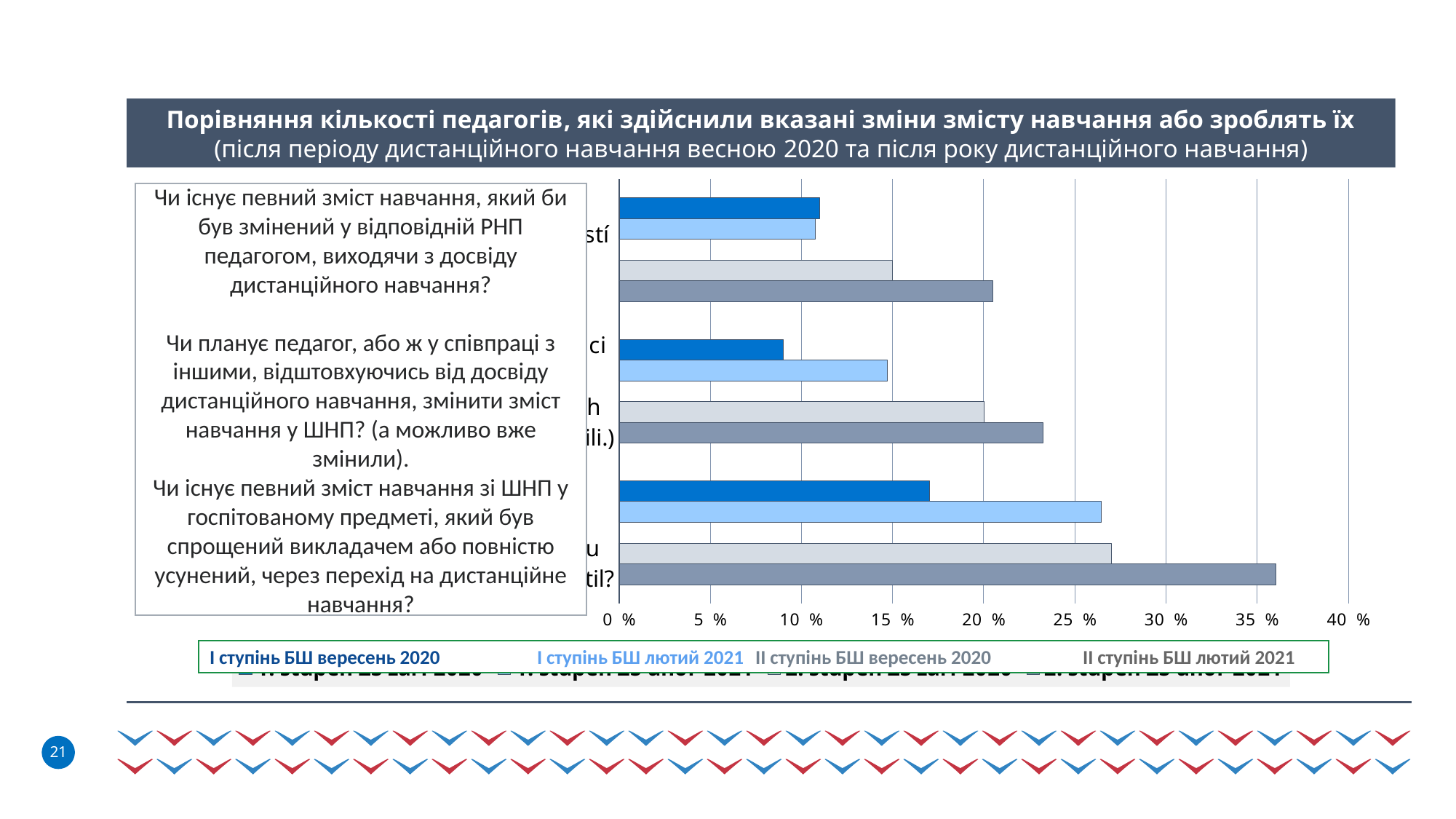
Is the value for ІІ ступінь БШ лютий 2021 in the top category greater or less than 15%? greater How many series does the legend list? 4 How many question categories are plotted on the chart? 3 Which series has the longest bar in the bottom category (content simplified or removed due to distance learning)? ІІ ступінь БШ лютий 2021 What is the maximum value shown on the horizontal axis? 40 % In the middle category, which is larger: І ступінь БШ вересень 2020 or І ступінь БШ лютий 2021? І ступінь БШ лютий 2021 Is the value for І ступінь БШ вересень 2020 in the middle category (planning to change content in ШНП) greater or less than 10%? less Which category has the longest bar overall on the chart? the bottom category (content simplified or removed due to distance learning) Is the value for ІІ ступінь БШ лютий 2021 in the bottom category greater or less than 30%? greater What kind of chart is shown on the slide? bar chart Which series has the shortest bar in the middle category? І ступінь БШ вересень 2020